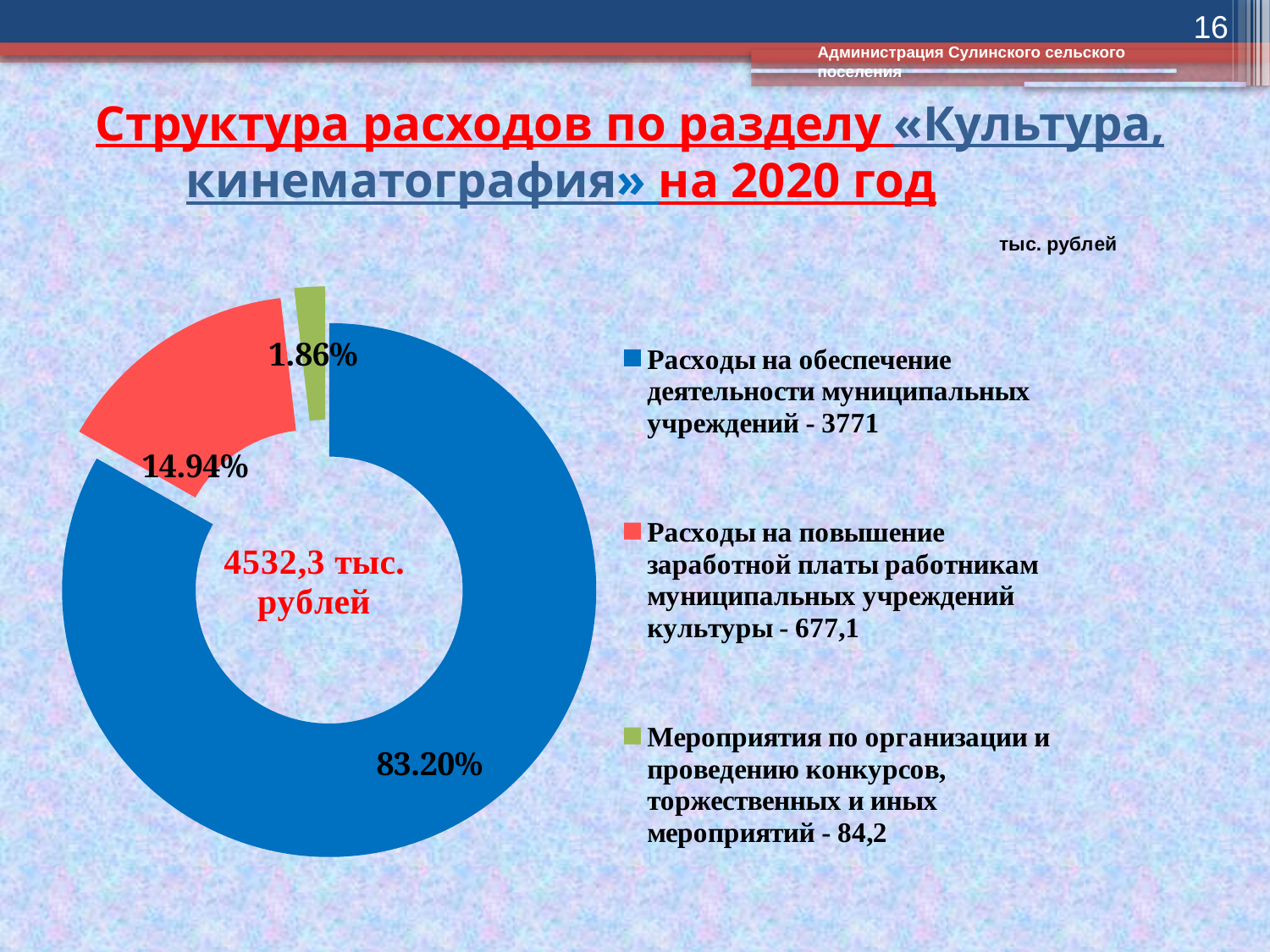
What share of the pie is labelled for «Мероприятия по организации и проведению конкурсов, торжественных и иных мероприятий»? 1.86% What share of the pie is labelled for «Расходы на обеспечение деятельности муниципальных учреждений»? 83.20% What share of the pie is labelled for «Расходы на повышение заработной платы работникам муниципальных учреждений культуры»? 14.94% How many slices does the pie chart have? 3 Which category has the largest slice of the pie? Расходы на обеспечение деятельности муниципальных учреждений Which is larger: the slice for «Расходы на повышение заработной платы работникам муниципальных учреждений культуры» or the slice for «Мероприятия по организации и проведению конкурсов, торжественных и иных мероприятий»? Расходы на повышение заработной платы работникам муниципальных учреждений культуры What colour is the largest slice of the pie chart? blue What total amount is printed in the centre of the pie chart? 4532,3 тыс. рублей According to the legend, what is the amount for «Расходы на повышение заработной платы работникам муниципальных учреждений культуры»? 677,1 What is the difference in percentage points between the largest slice (83.20%) and the slice for «Расходы на повышение заработной платы работникам муниципальных учреждений культуры» (14.94%)? 68.26 percentage points What kind of chart is shown on the slide? doughnut chart Which category has the smallest slice of the pie? Мероприятия по организации и проведению конкурсов, торжественных и иных мероприятий